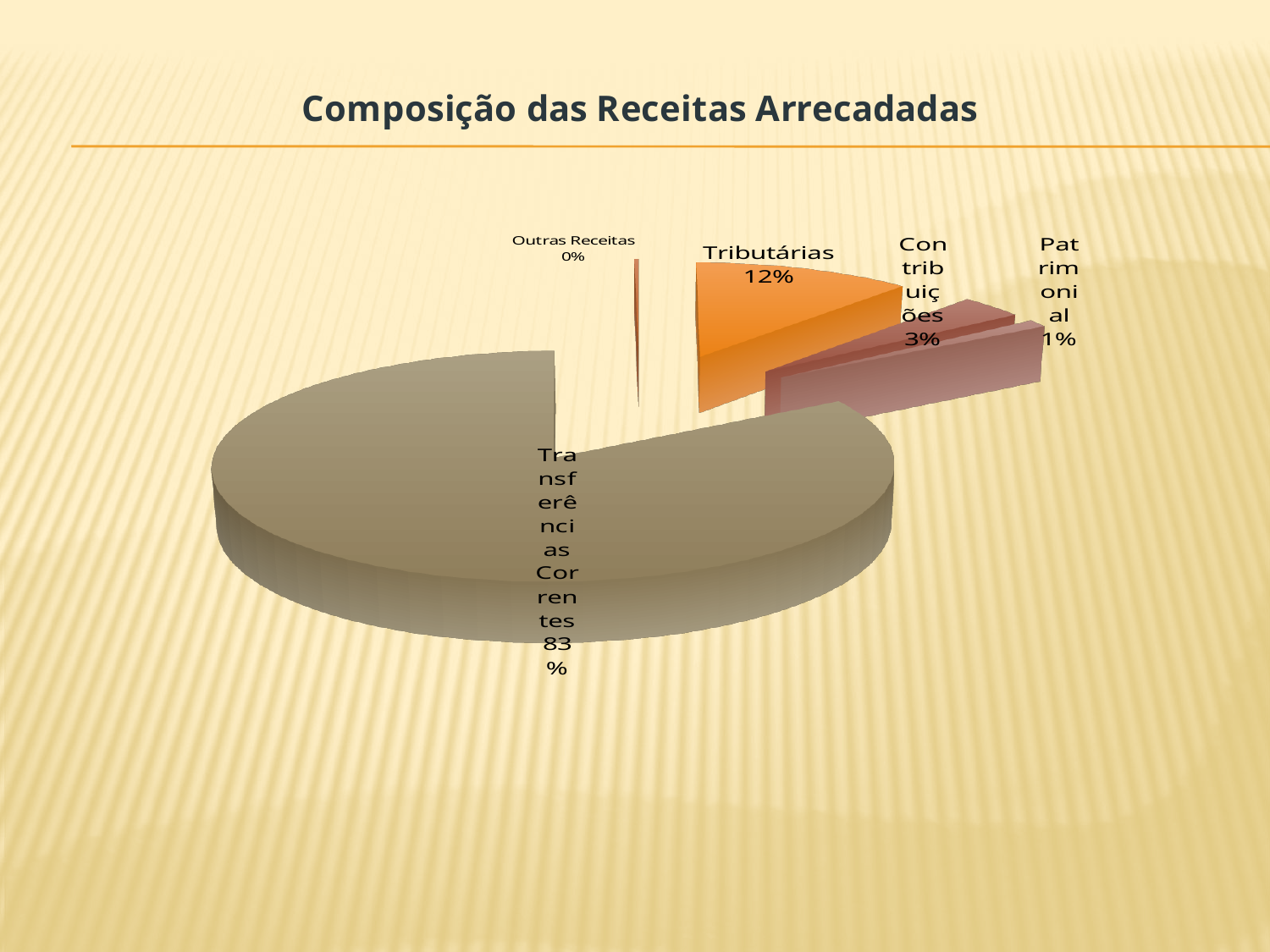
What percentage is shown for Outras Receitas? 0% What kind of chart is shown on the slide? Pie chart Which category has the largest share of the pie? Transferências Correntes What percentage is shown for Tributárias? 12% What percentage is shown for Contribuições? 3% What percentage is shown for Patrimonial? 1% What is the title of the chart? Composição das Receitas Arrecadadas What is the difference in percentage points between Transferências Correntes and Tributárias? 71 Which is larger, the share for Contribuições or the share for Patrimonial? Contribuições What share of the pie does Transferências Correntes represent? 83% Which category has the smallest share of the pie? Outras Receitas How many slices (categories) does the pie chart have? 5